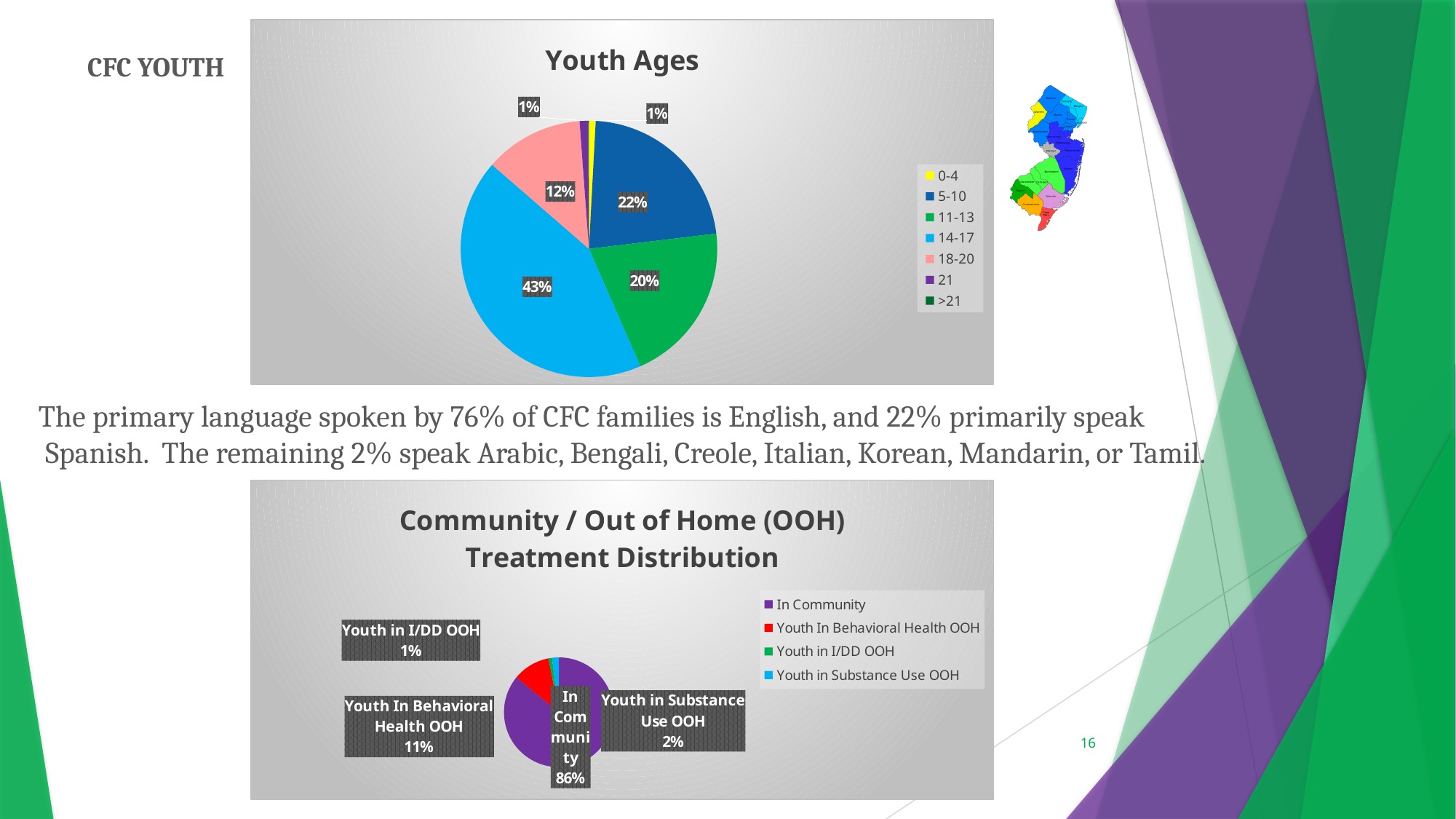
In the Youth Ages chart, what is the difference between the 14-17 share and the 11-13 share? 23% In the Community / Out of Home (OOH) Treatment Distribution chart, what share is In Community? 86% How many entries does the legend of the Youth Ages chart list? 7 In the Youth Ages chart, what share of youth are aged 14-17? 43% How many categories does the legend of the Community / Out of Home (OOH) Treatment Distribution chart list? 4 In the Youth Ages chart, which is larger, the 5-10 share or the 11-13 share? 5-10 In the Community / Out of Home (OOH) Treatment Distribution chart, which category has the smallest share? Youth in I/DD OOH In the Youth Ages chart, what share of youth are aged 18-20? 12% In the Community / Out of Home (OOH) Treatment Distribution chart, what share is Youth In Behavioral Health OOH? 11% In the Youth Ages chart, which age group has the largest share? 14-17 What kind of chart is the Youth Ages chart? Pie chart In the Youth Ages chart, what share of youth are aged 5-10? 22%